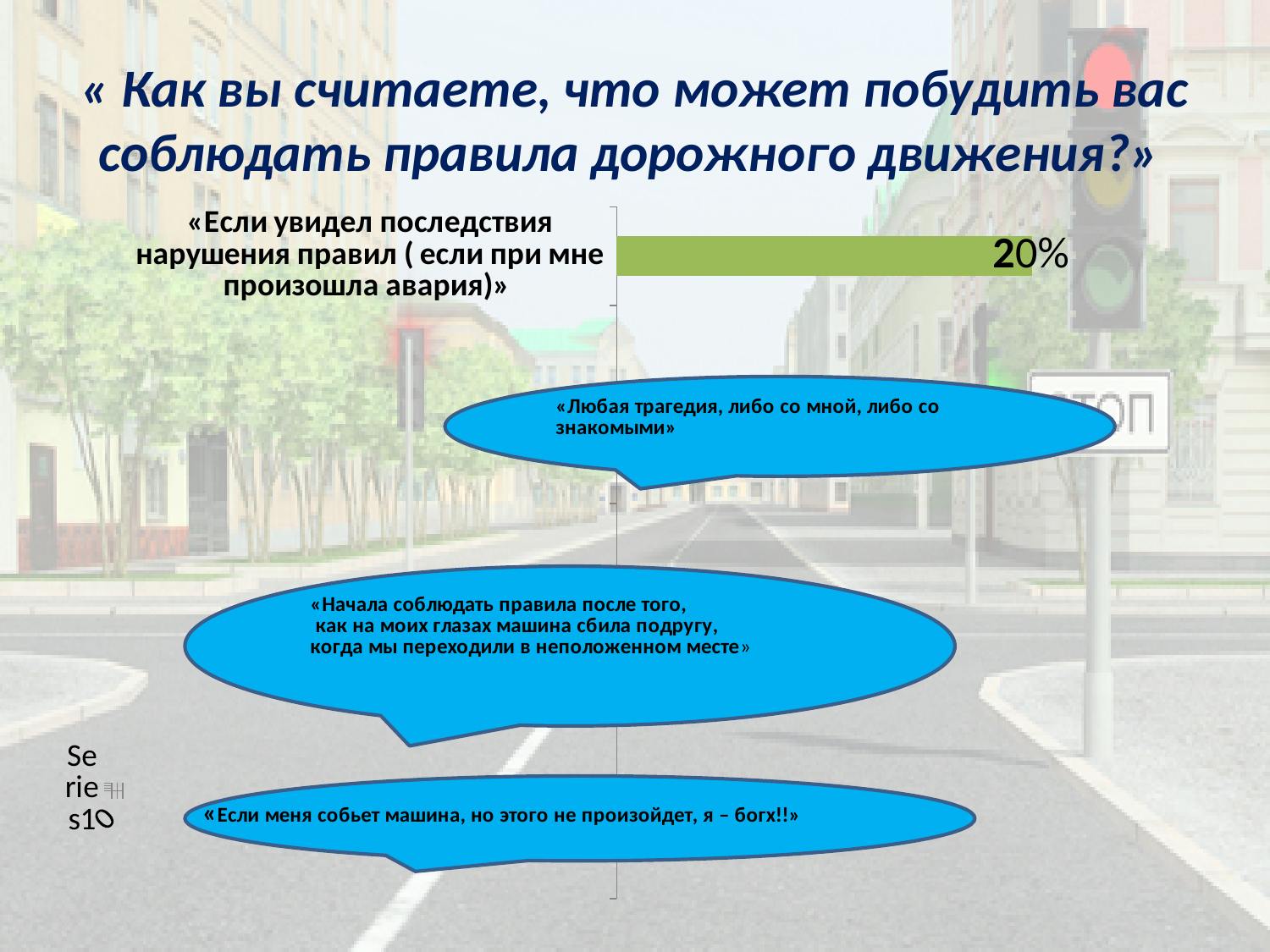
What kind of chart is shown on the slide? bar chart What colour is the bar for «Если увидел последствия нарушения правил (если при мне произошла авария)»? green What question is the chart on the slide about, according to the slide title? «Как вы считаете, что может побудить вас соблюдать правила дорожного движения?» What value is shown for the category «Если увидел последствия нарушения правил (если при мне произошла авария)»? 20%